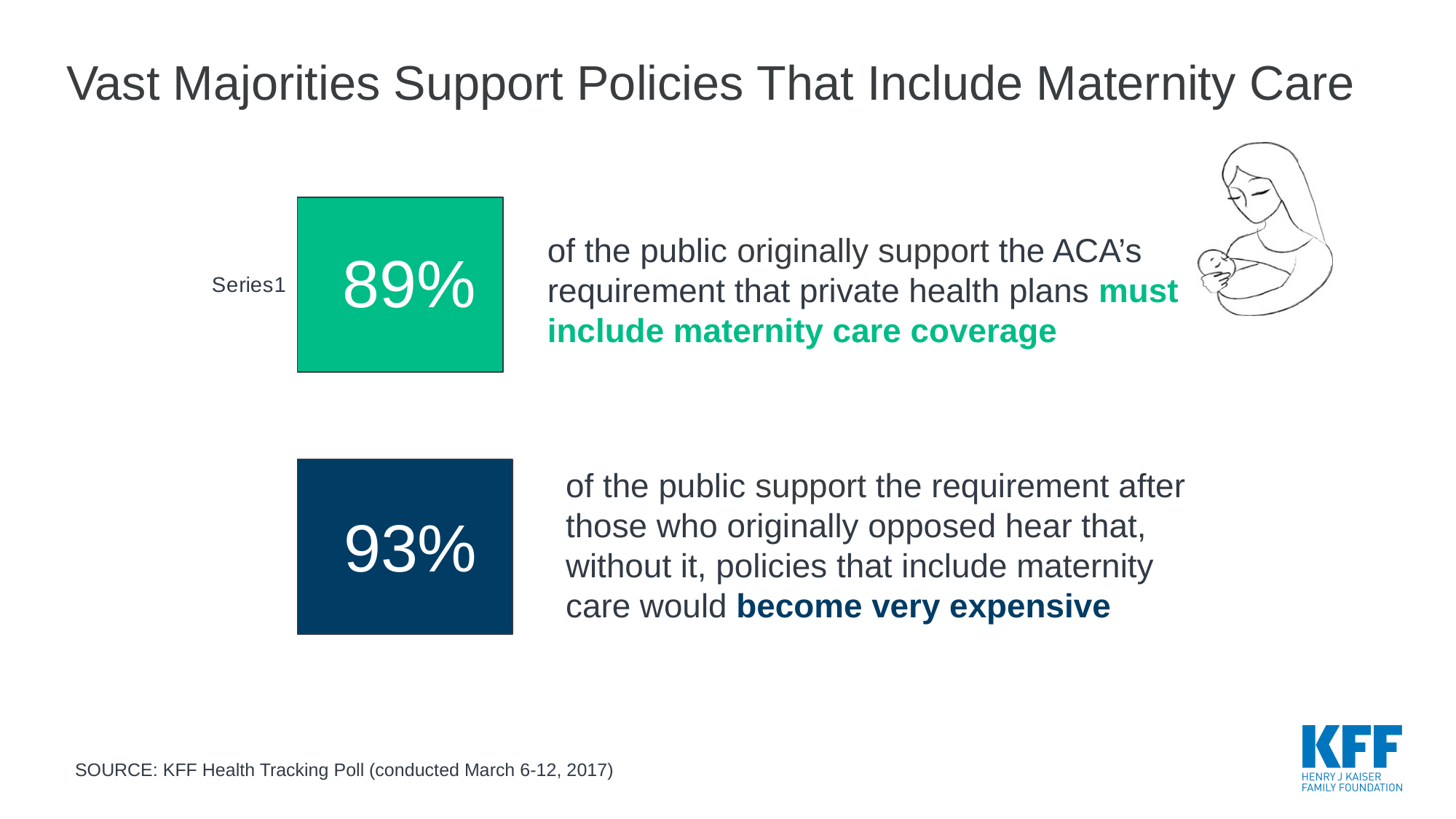
Is the original support for the maternity care requirement greater or less than 80%? greater Which of the two figures shown is the highest? 93% What is the title of the slide? Vast Majorities Support Policies That Include Maternity Care What is the source of the data shown on the slide? KFF Health Tracking Poll (conducted March 6-12, 2017) Which of the two figures shown is the lowest? 89% Which value is larger: the original support for the maternity care requirement or the support after hearing that policies would become very expensive? 93% (after hearing policies would become very expensive) What percentage of the public support the requirement after those who originally opposed hear that, without it, policies that include maternity care would become very expensive? 93% What colour is the box showing 89%? Green How many percentage figures are displayed on the slide? 2 By how many percentage points does support for the requirement rise after opponents hear that policies would become very expensive? 4 percentage points What percentage of the public originally supported the ACA's requirement that private health plans must include maternity care coverage? 89%